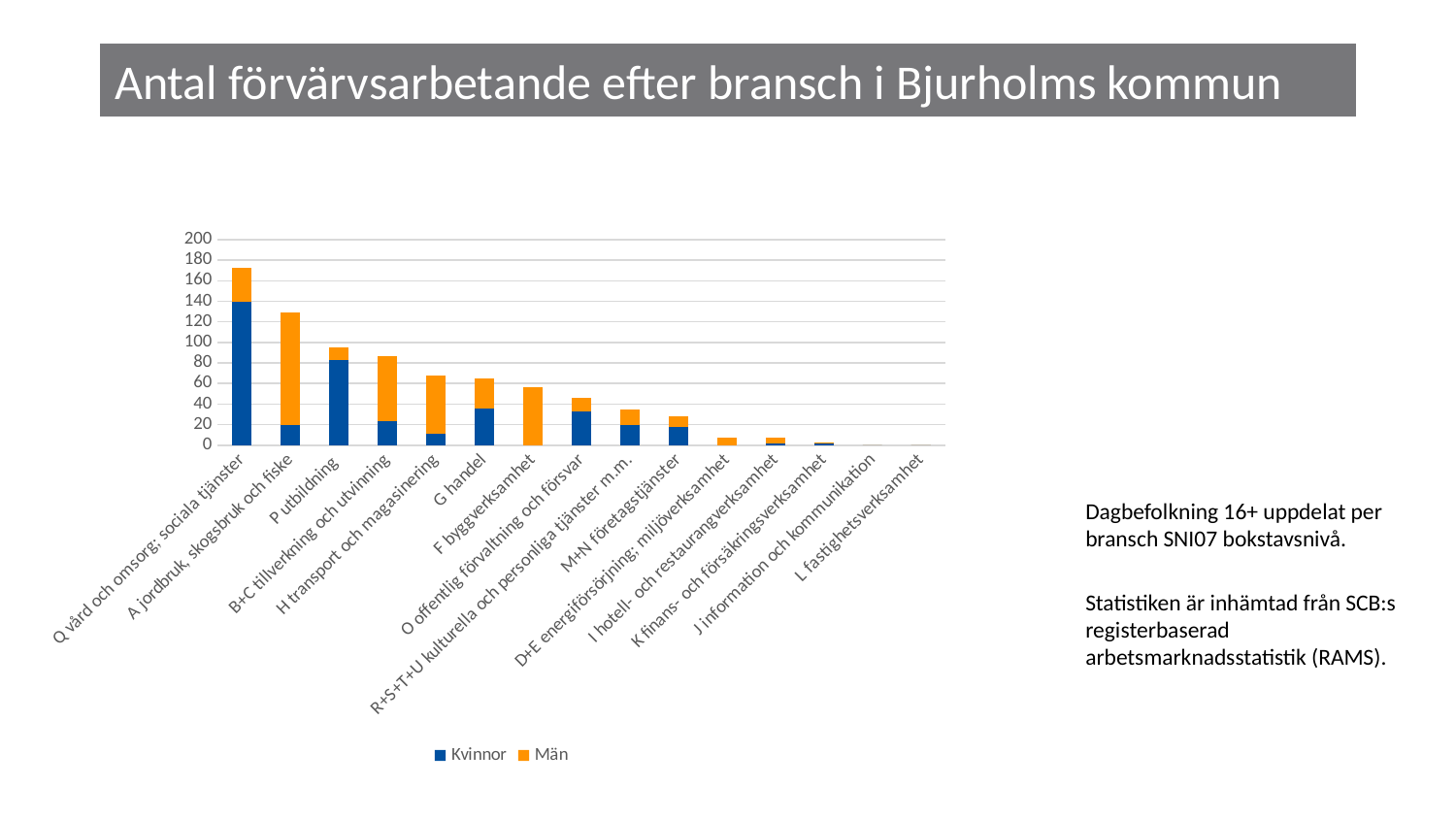
Is the total value for P utbildning greater or less than 100? less How many industry categories are shown on the x axis? 15 Which has a larger total, A jordbruk, skogsbruk och fiske or B+C tillverkning och utvinning? A jordbruk, skogsbruk och fiske What kind of chart is shown on the slide? stacked bar chart What are the two series named in the legend? Kvinnor and Män Which category has the lowest total number of employed persons? J information och kommunikation and L fastighetsverksamhet Is the total value for Q vård och omsorg; sociala tjänster greater or less than 160? greater Which category has the highest total number of employed persons? Q vård och omsorg; sociala tjänster How many series does the legend list? 2 Do the total values rise or fall moving from left to right along the x axis? fall Is the Kvinnor value for Q vård och omsorg; sociala tjänster greater or less than 120? greater